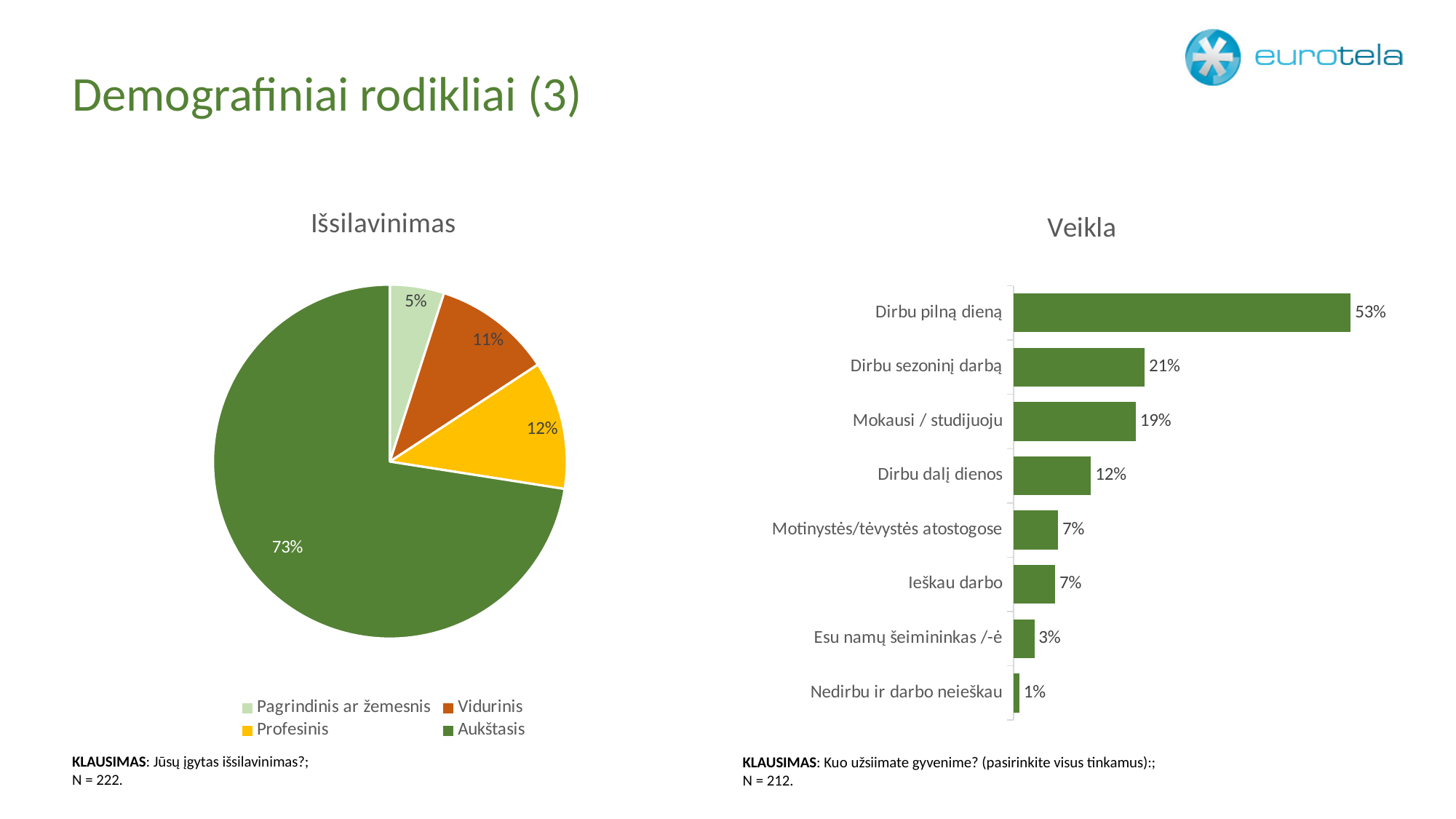
In the 'Išsilavinimas' chart, what is the difference between 'Profesinis' and 'Vidurinis'? 1% In the 'Išsilavinimas' chart, what share does 'Aukštasis' have? 73% In the 'Veikla' chart, what is the value for 'Mokausi / studijuoju'? 19% In the 'Išsilavinimas' chart, what share does 'Vidurinis' have? 11% In the 'Veikla' chart, what is the difference between 'Dirbu pilną dieną' and 'Dirbu sezoninį darbą'? 32% In the 'Išsilavinimas' chart, how many categories does the legend list? 4 In the 'Veikla' chart, which category has the highest value? Dirbu pilną dieną In the 'Išsilavinimas' chart, which category has the smallest slice? Pagrindinis ar žemesnis What kind of chart is the 'Išsilavinimas' chart? Pie chart In the 'Veikla' chart, what is the value for 'Esu namų šeimininkas /-ė'? 3% What kind of chart is the 'Veikla' chart? Bar chart In the 'Veikla' chart, which category has the lowest value? Nedirbu ir darbo neieškau